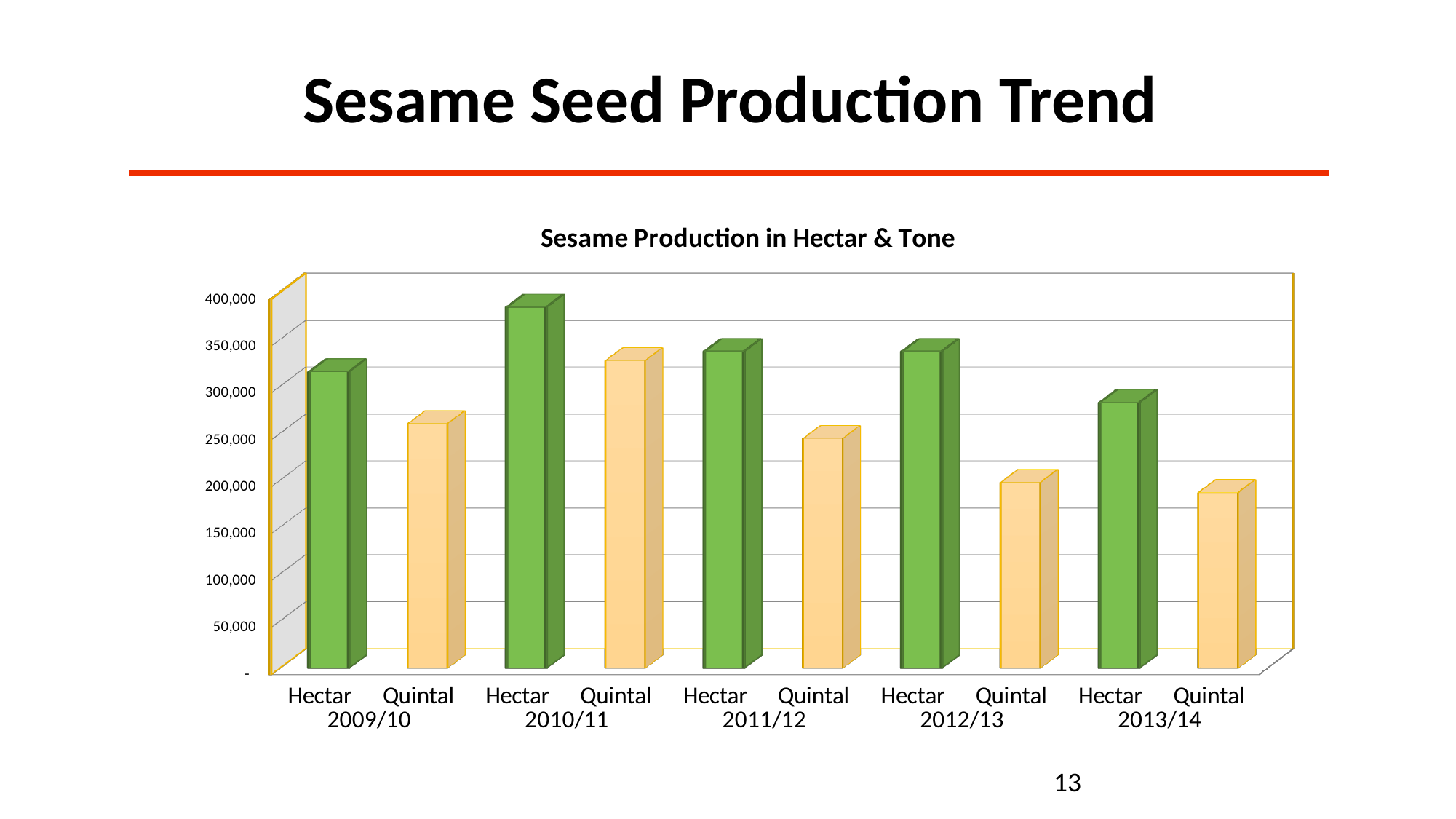
Which is larger, the Hectar value for 2010/11 or the Hectar value for 2011/12? 2010/11 Is the value for Quintal 2010/11 greater or less than 300,000? greater Do the Quintal values rise or fall from 2010/11 to 2013/14? fall What is the title of the chart? Sesame Production in Hectar & Tone Which is larger in 2009/10, the Hectar value or the Quintal value? Hectar Is the value for Quintal 2012/13 greater or less than 250,000? less What type of chart is shown on the slide? Bar chart Among the Hectar bars, which year has the lowest value? 2013/14 Is the value for Hectar 2010/11 greater or less than 350,000? greater Which bar has the highest value in the chart? Hectar 2010/11 How many bars are plotted in the chart? 10